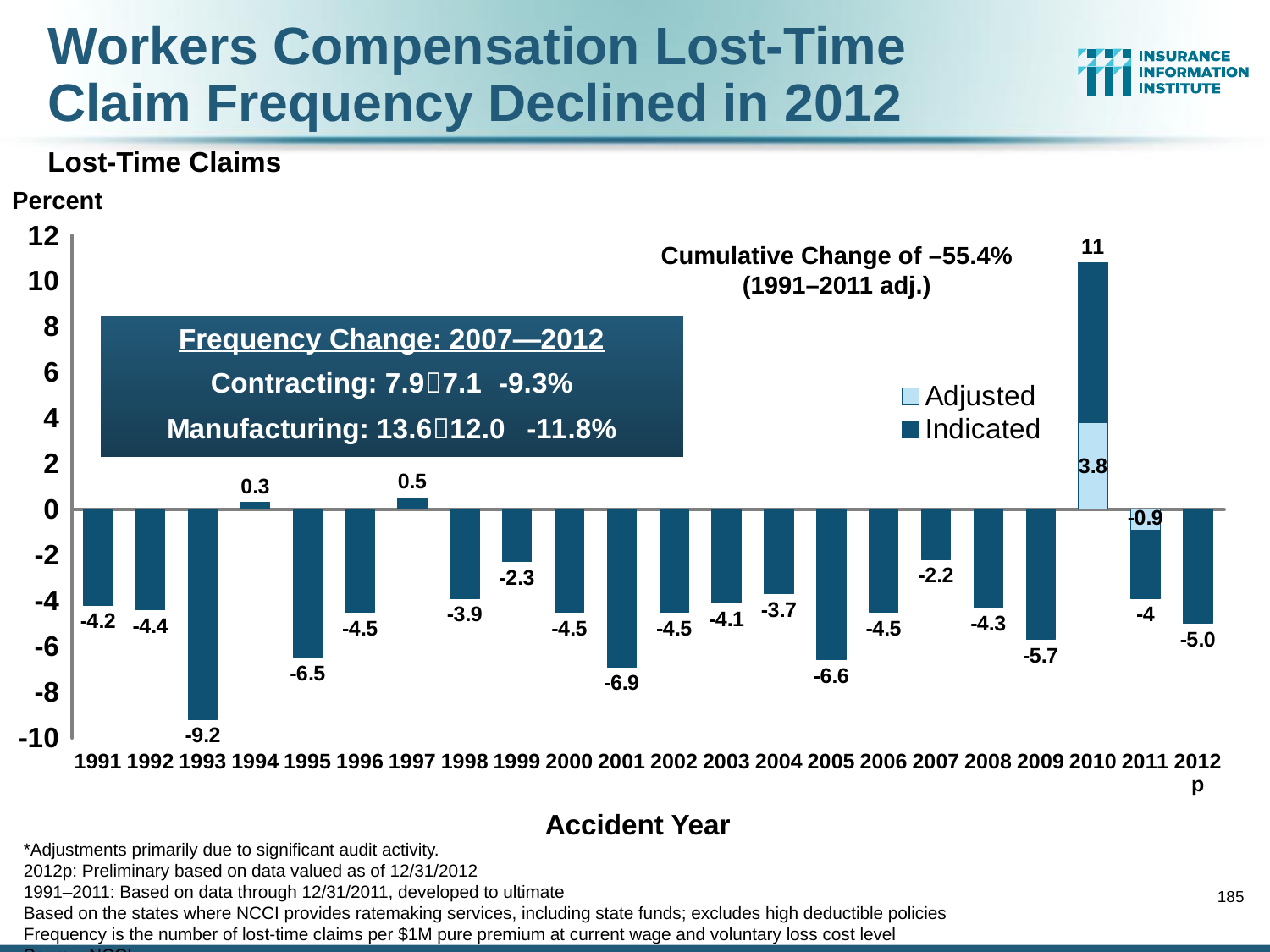
What is the value shown for accident year 2012p? -5.0 How many accident years are shown on the x axis? 22 What is the indicated value for accident year 1993? -9.2 How many series does the legend list? 2 What is the adjusted value shown for accident year 2010? 3.8 What are the two entries in the chart legend? Adjusted and Indicated Which accident year has the highest value on the chart? 2010 Which accident year has the lowest (most negative) value on the chart? 1993 What is the difference between the values for 2001 and 2005? 0.3 Which accident year has the larger value, 1994 or 1997? 1997 What kind of chart is shown on the slide? Bar chart What is the indicated value shown for accident year 2010? 11